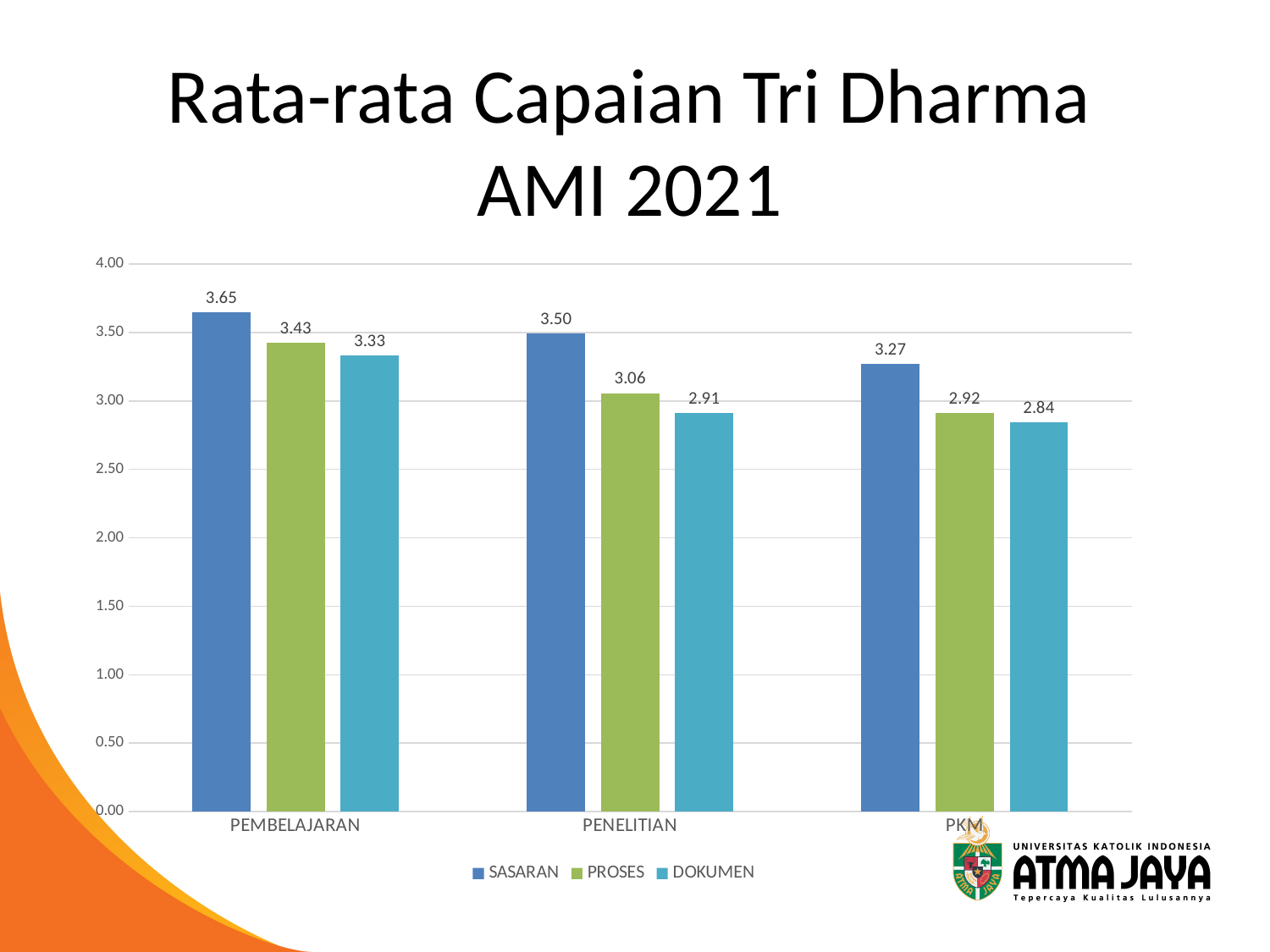
What is the SASARAN value for PEMBELAJARAN? 3.65 Which category has the highest SASARAN value? PEMBELAJARAN Which category has the lowest DOKUMEN value? PKM How many series does the legend list? 3 What is the difference between the SASARAN and PROSES values for PENELITIAN? 0.44 What is the title of the slide? Rata-rata Capaian Tri Dharma AMI 2021 What is the PROSES value for PKM? 2.92 Which is larger: the PROSES value for PEMBELAJARAN or the SASARAN value for PKM? PROSES value for PEMBELAJARAN Is the DOKUMEN value for PKM greater or less than 3.00? less How many categories are shown on the x axis? 3 What kind of chart is shown on the slide? bar chart What is the DOKUMEN value for PENELITIAN? 2.91